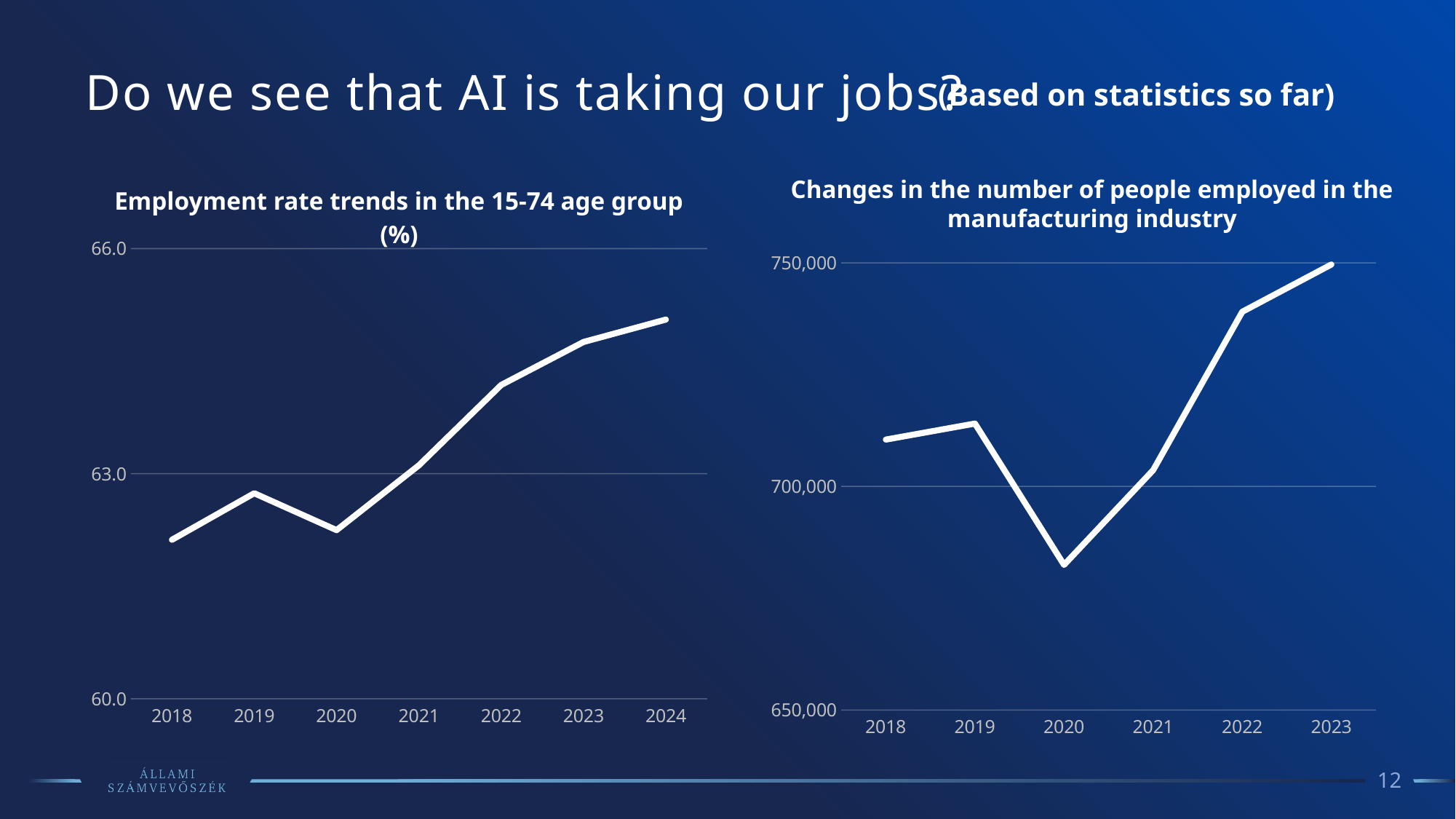
In the left chart, 'Employment rate trends in the 15-74 age group (%)', which year has the lowest employment rate? 2018 How many years are plotted on the x axis of the left chart, 'Employment rate trends in the 15-74 age group (%)'? 7 How many years are plotted on the x axis of the right chart, 'Changes in the number of people employed in the manufacturing industry'? 6 In the right chart, 'Changes in the number of people employed in the manufacturing industry', which year has the highest number of people employed? 2023 In the right chart, 'Changes in the number of people employed in the manufacturing industry', does the line rise or fall from 2020 to 2023? rise In the left chart, 'Employment rate trends in the 15-74 age group (%)', is the value for 2018 greater or less than 63.0? less In the right chart, 'Changes in the number of people employed in the manufacturing industry', is the value for 2020 greater or less than 700,000? less In the right chart, 'Changes in the number of people employed in the manufacturing industry', which year has the lowest number of people employed? 2020 In the left chart, 'Employment rate trends in the 15-74 age group (%)', which year has the higher value, 2019 or 2020? 2019 What kind of chart is the 'Employment rate trends in the 15-74 age group (%)' chart on the left? line chart In the left chart, 'Employment rate trends in the 15-74 age group (%)', is the value for 2022 greater or less than 63.0? greater In the left chart, 'Employment rate trends in the 15-74 age group (%)', which year has the highest employment rate? 2024